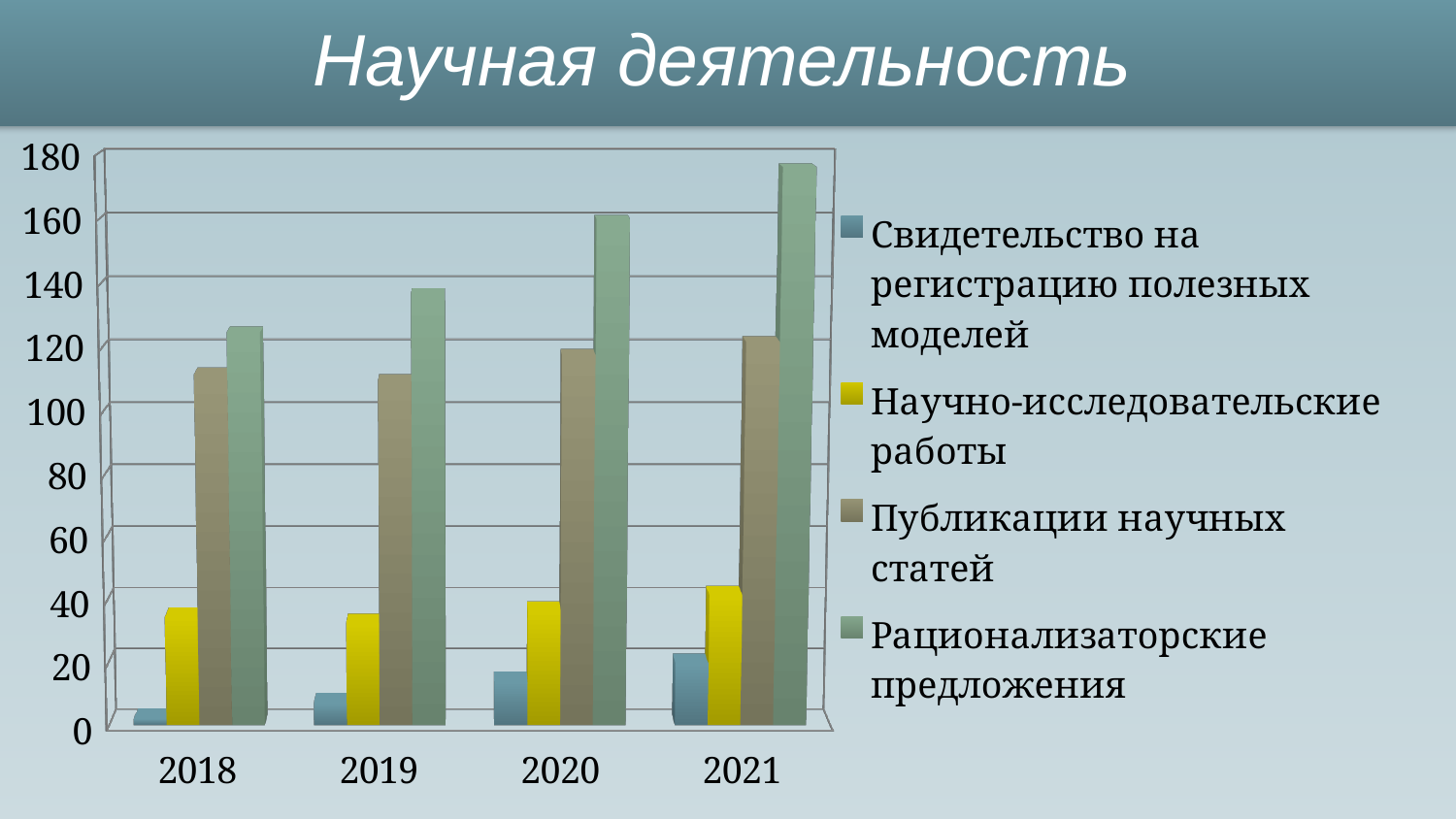
Is the value for Свидетельство на регистрацию полезных моделей in 2021 greater or less than 40? less How many series does the legend list? 4 Is the value for Публикации научных статей in 2019 greater or less than 100? greater Is the value for Рационализаторские предложения in 2021 greater or less than 160? greater In 2020, which is larger: Рационализаторские предложения or Публикации научных статей? Рационализаторские предложения Which year has the lowest value for Свидетельство на регистрацию полезных моделей? 2018 Do the values for Рационализаторские предложения rise or fall from 2018 to 2021? rise What is the title of the slide with the chart? Научная деятельность How many years are shown on the x axis of the chart? 4 Which year has the highest value for Рационализаторские предложения? 2021 What kind of chart is shown on the slide? bar chart